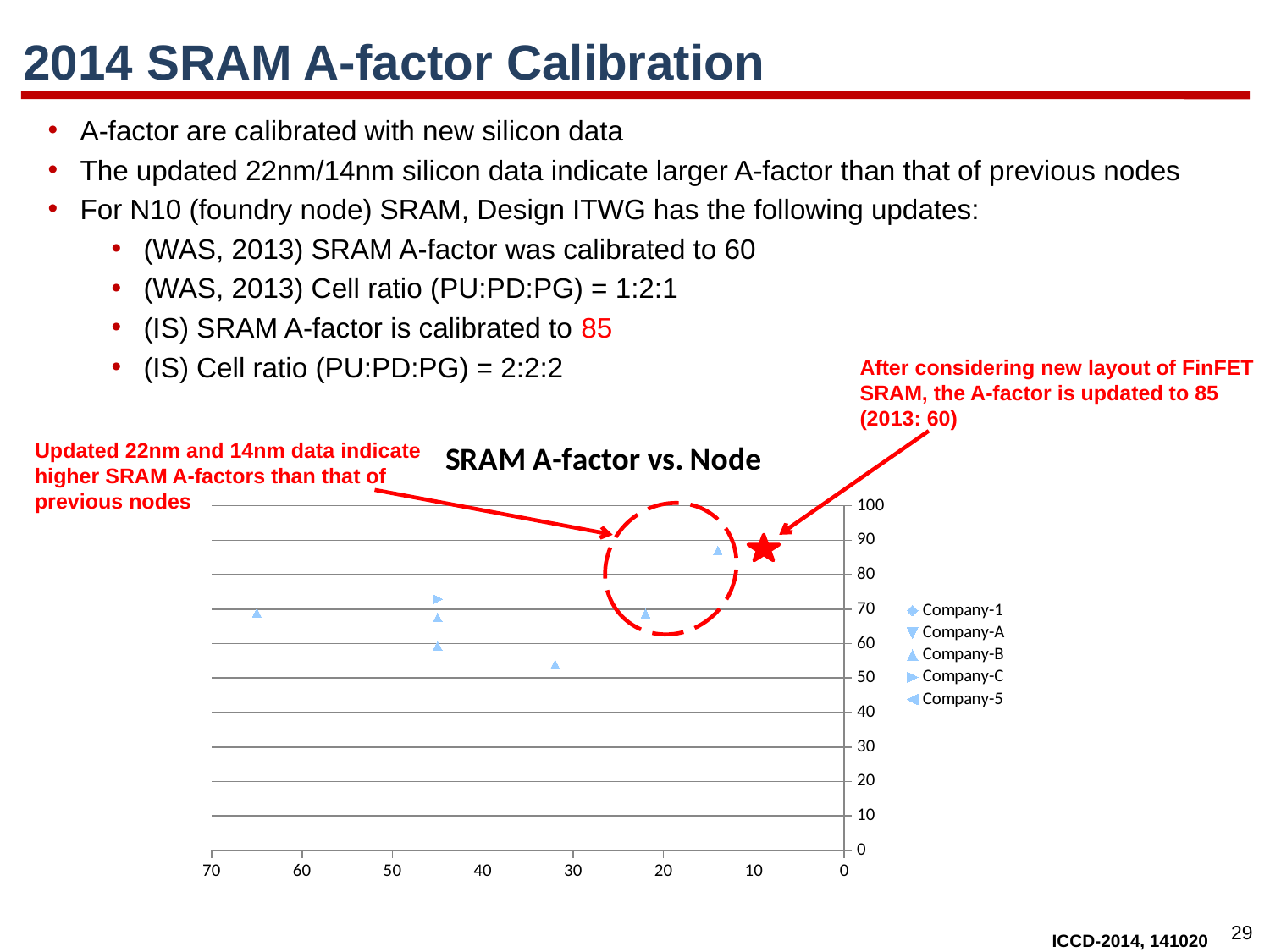
What is the leftmost value shown on the chart's horizontal (node) axis? 70 How many data points are plotted at node 45? 3 What is the highest value shown on the chart's vertical axis? 100 Which has the larger A-factor: the point plotted at node 65 or the point plotted at node 32? node 65 Is the A-factor value plotted at node 65 greater or less than 60? greater What is the title of the chart on the slide? SRAM A-factor vs. Node How many series does the chart's legend list? 5 Is the triangle plotted near node 14 greater or less than 80? greater Which series are listed in the chart's legend? Company-1, Company-A, Company-B, Company-C, Company-5 Which has the larger A-factor: the triangle plotted near node 14 or the triangle plotted near node 22? node 14 Is the A-factor value plotted at node 32 greater or less than 60? less What kind of chart is shown on the slide? scatter chart